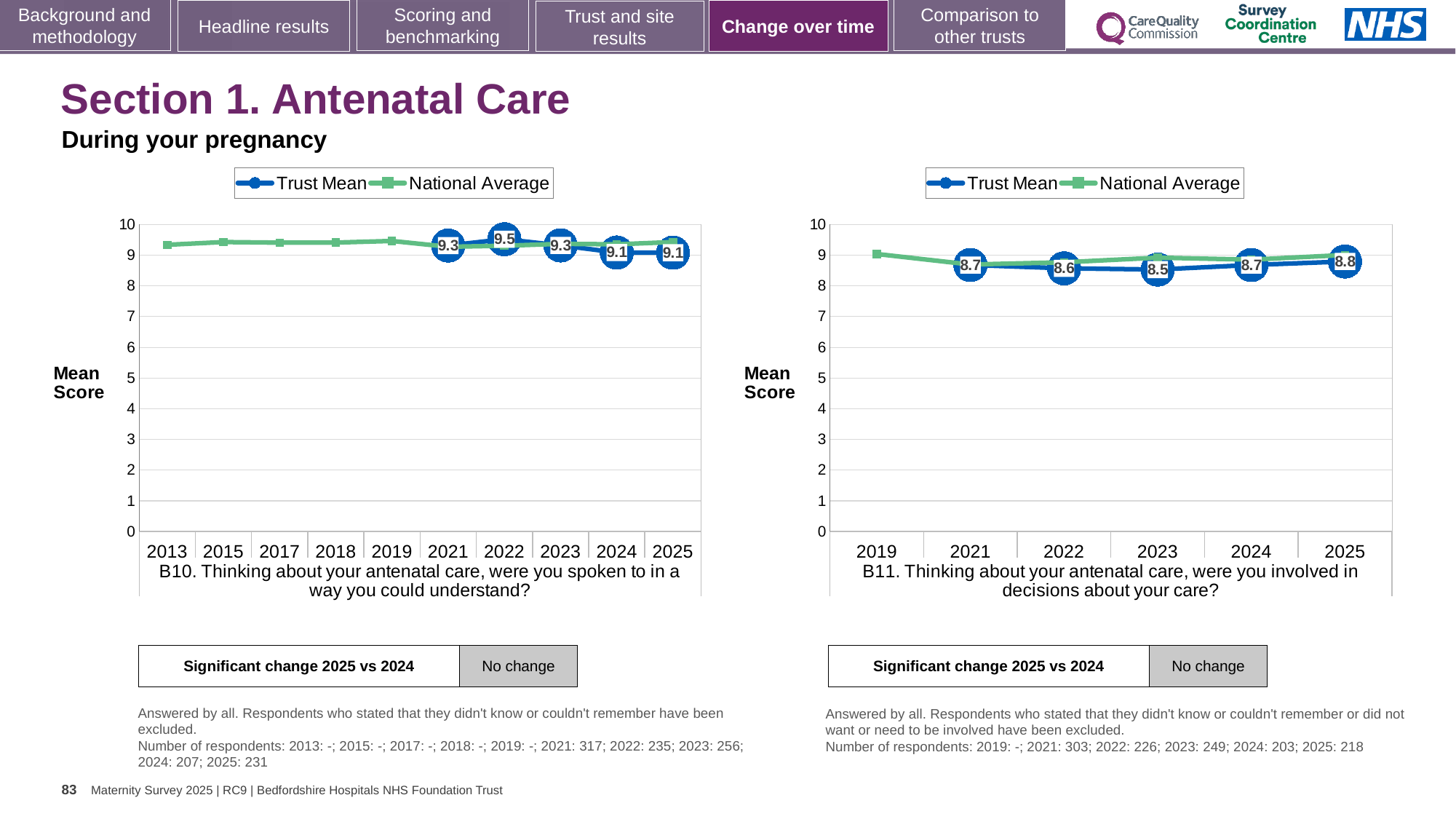
In the B11 chart, which year has the lowest Trust Mean? 2023 What kind of chart is the B11 chart? line chart In the B10 chart, what is the Trust Mean for 2022? 9.5 In the B11 chart, what is the Trust Mean for 2025? 8.8 In the B10 chart, what is the Trust Mean for 2025? 9.1 In the B10 chart, what is the difference between the Trust Mean for 2022 and the Trust Mean for 2024? 0.4 In the B11 chart, is the Trust Mean for 2021 larger or smaller than the Trust Mean for 2023? larger In the B10 chart, is the National Average for 2013 greater or less than 9? greater How many series does the legend of the B10 chart list? 2 In the B10 chart, which year has the highest Trust Mean? 2022 In the B11 chart, what is the Trust Mean for 2023? 8.5 How many years are shown on the x axis of the B11 chart? 6